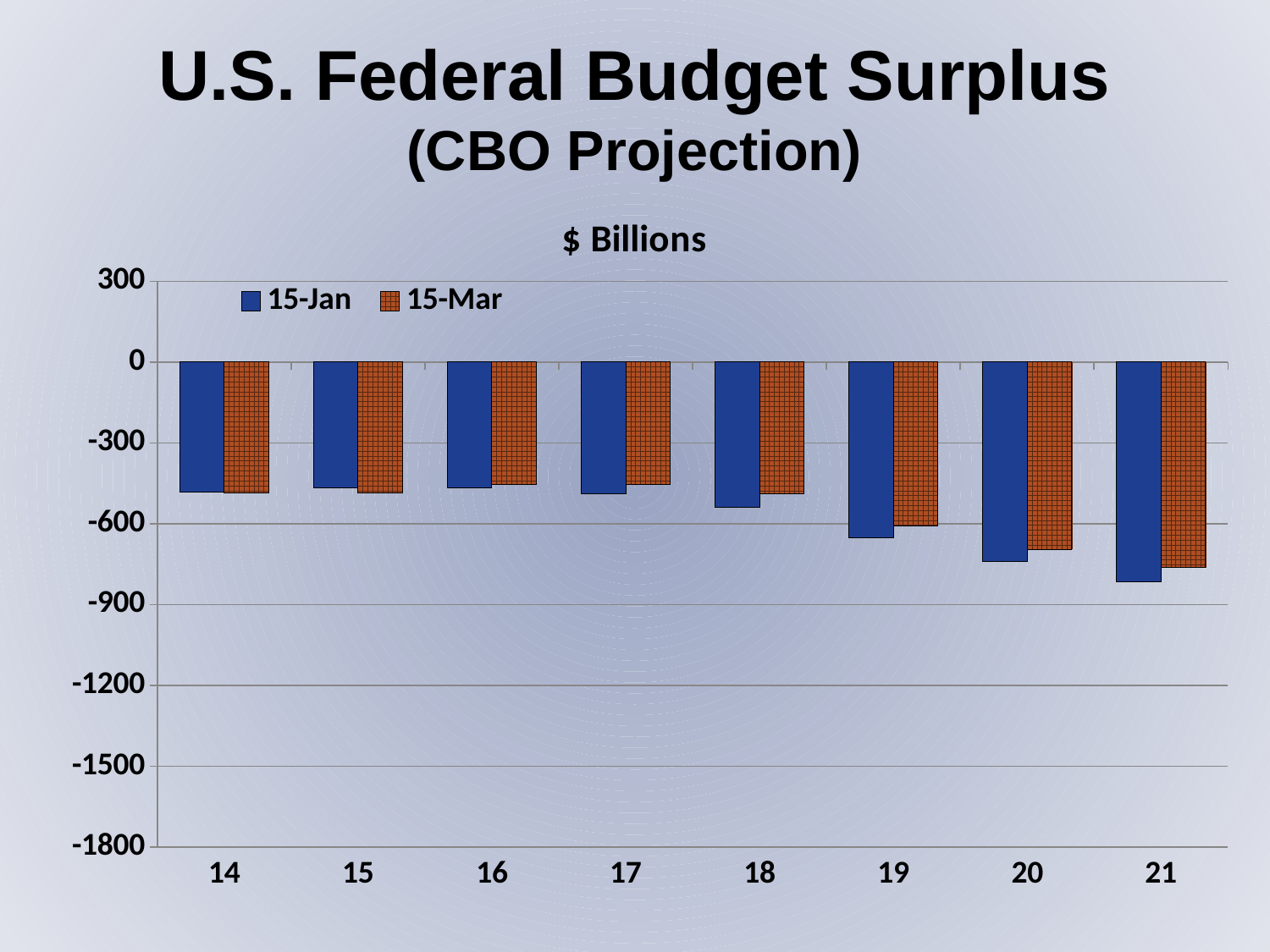
How many years (categories) are shown on the x axis? 8 What kind of chart is shown on the slide? bar chart Is the 15-Jan value for year 21 greater or less than -600? less For year 21, which series has the lower (more negative) value, 15-Jan or 15-Mar? 15-Jan How many series does the legend list? 2 Which year has the lowest (most negative) 15-Jan value? 21 What unit label is shown above the chart? $ Billions Is the 15-Jan value for year 14 greater or less than -300? less What are the two series named in the legend? 15-Jan and 15-Mar For year 19, which series has the lower (more negative) value, 15-Jan or 15-Mar? 15-Jan Which year has the lowest (most negative) 15-Mar value? 21 From year 17 to year 21, do the 15-Jan values rise or fall? fall